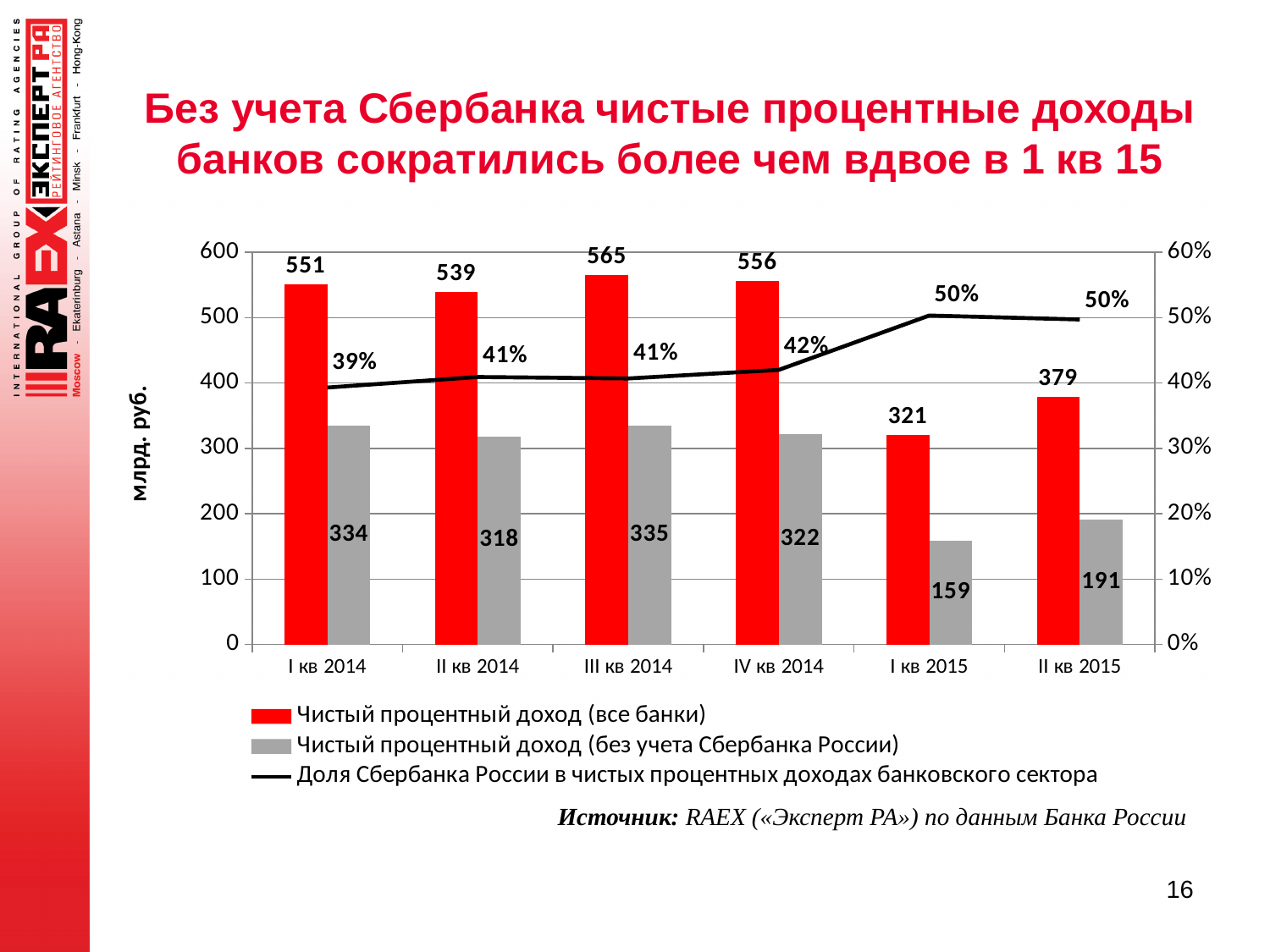
What kind of chart is shown on the slide? Combined bar and line chart What is the difference between 'Чистый процентный доход (все банки)' in IV кв 2014 and I кв 2015? 235 Which is larger: 'Чистый процентный доход (без учета Сбербанка России)' in I кв 2014 or in II кв 2014? I кв 2014 In which quarter is 'Чистый процентный доход (без учета Сбербанка России)' the lowest? I кв 2015 Does 'Доля Сбербанка России в чистых процентных доходах банковского сектора' rise or fall from I кв 2014 to I кв 2015? Rise In which quarter is 'Чистый процентный доход (все банки)' the highest? III кв 2014 How many series does the legend list? 3 How many quarters are shown on the x axis? 6 What is the unit shown on the left vertical axis label? млрд. руб. What is the value of 'Доля Сбербанка России в чистых процентных доходах банковского сектора' for IV кв 2014? 42% What is the value of 'Чистый процентный доход (все банки)' for III кв 2014? 565 What is the value of 'Чистый процентный доход (без учета Сбербанка России)' for I кв 2015? 159